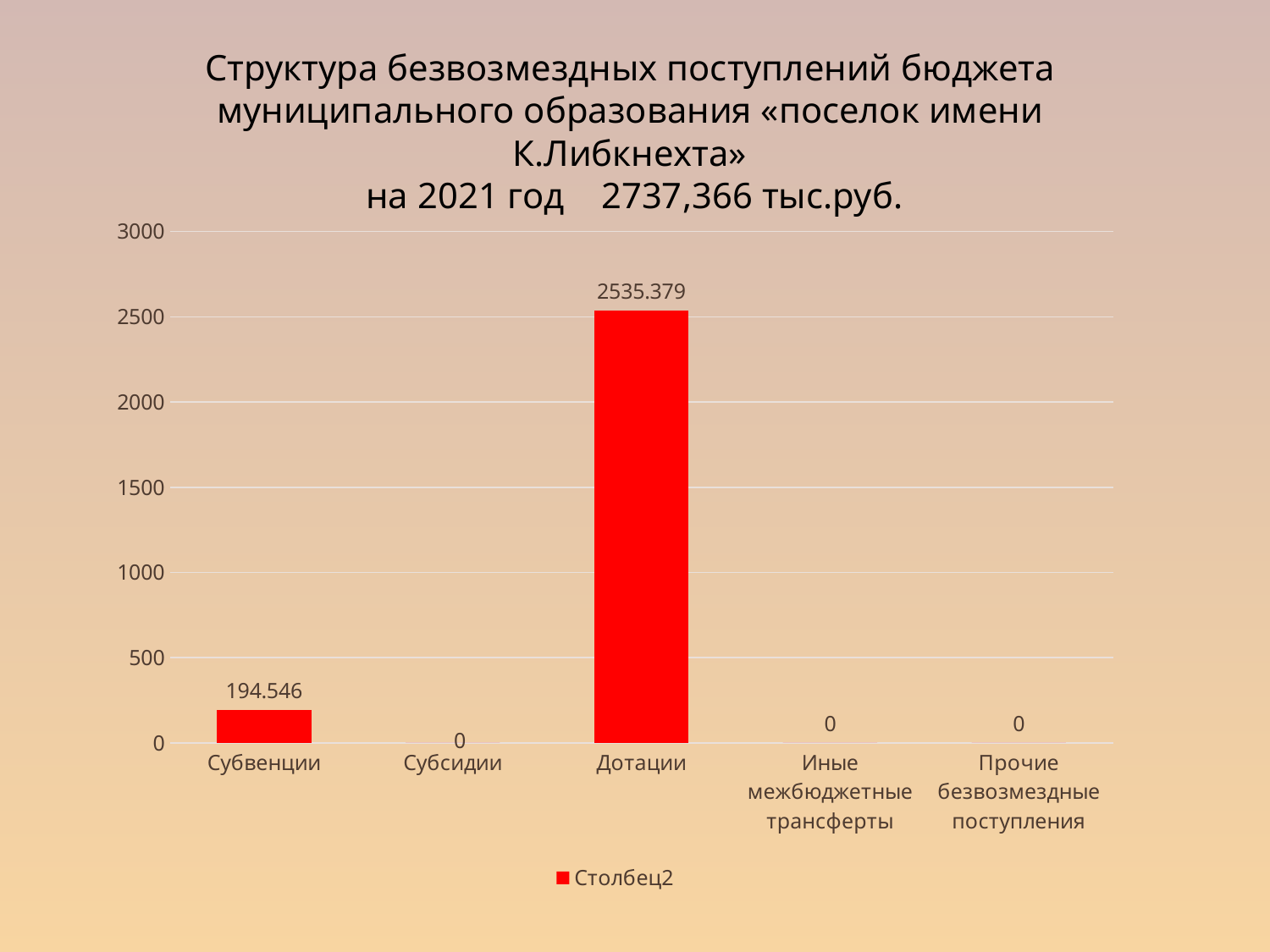
How many categories are shown on the x axis? 5 Which is larger, the value for Субвенции or the value for Дотации? Дотации What is the value for Субсидии? 0 Is the value for Дотации greater or less than 2500? greater What kind of chart is shown on the slide? bar chart What is the difference between the values for Дотации and Субвенции? 2340.833 How many series does the legend list? 1 Which category has the highest value? Дотации What is the value for Дотации? 2535.379 What is the value for Иные межбюджетные трансферты? 0 What is the value for Субвенции? 194.546 What is the name of the series in the legend? Столбец2